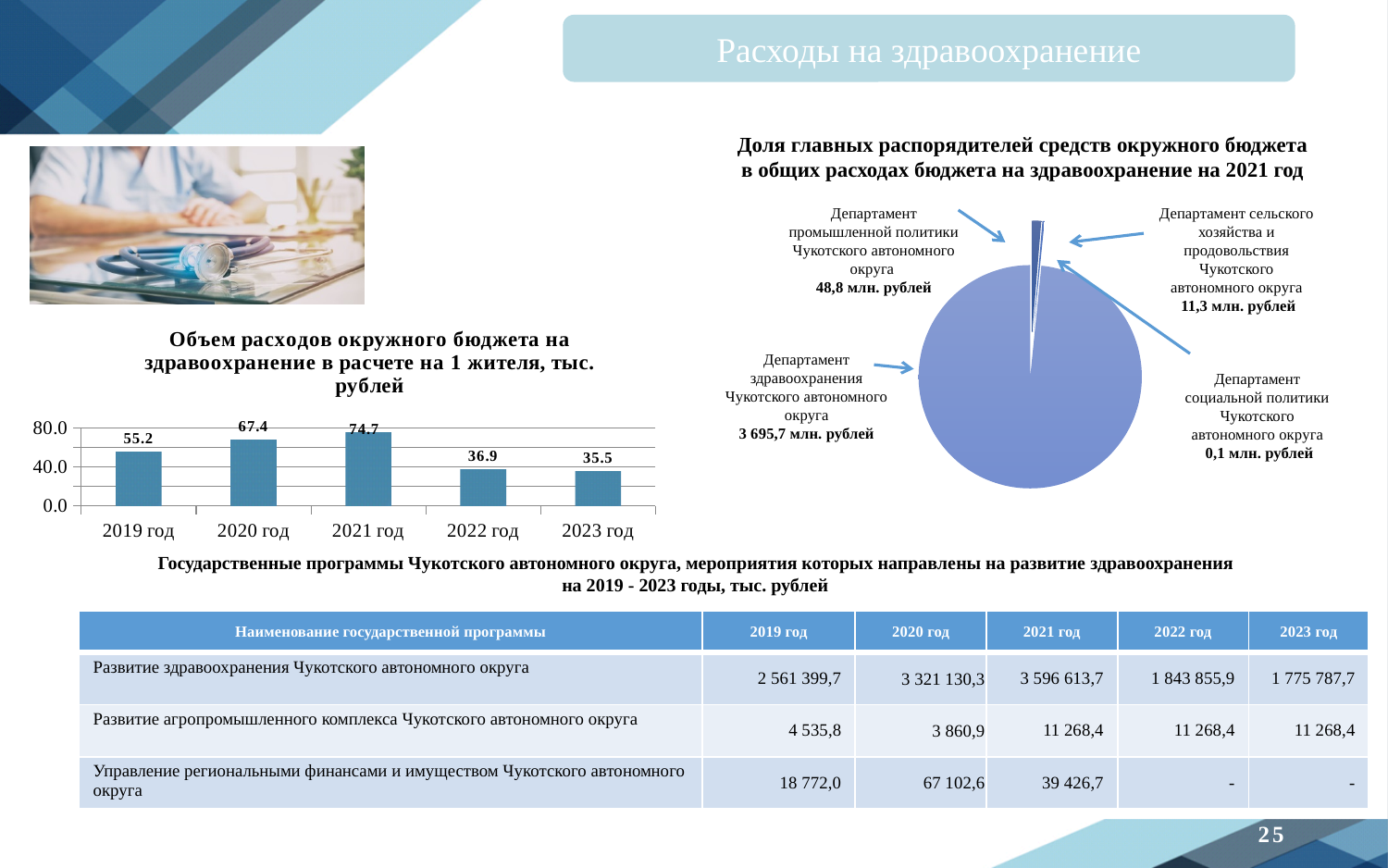
On the pie chart 'Доля главных распорядителей средств окружного бюджета в общих расходах бюджета на здравоохранение на 2021 год', what is the value for Департамент здравоохранения Чукотского автономного округа? 3 695,7 млн. рублей On the bar chart 'Объем расходов окружного бюджета на здравоохранение в расчете на 1 жителя, тыс. рублей', do the values rise or fall from 2021 год to 2023 год? fall On the bar chart 'Объем расходов окружного бюджета на здравоохранение в расчете на 1 жителя, тыс. рублей', which is larger: the value for 2020 год or 2022 год? 2020 год On the pie chart 'Доля главных распорядителей средств окружного бюджета в общих расходах бюджета на здравоохранение на 2021 год', which department has the smallest value? Департамент социальной политики Чукотского автономного округа On the bar chart 'Объем расходов окружного бюджета на здравоохранение в расчете на 1 жителя, тыс. рублей', which year has the highest value? 2021 год On the bar chart 'Объем расходов окружного бюджета на здравоохранение в расчете на 1 жителя, тыс. рублей', what is the difference between the values for 2021 год and 2022 год? 37.8 On the bar chart 'Объем расходов окружного бюджета на здравоохранение в расчете на 1 жителя, тыс. рублей', what is the value for 2021 год? 74.7 On the bar chart 'Объем расходов окружного бюджета на здравоохранение в расчете на 1 жителя, тыс. рублей', what is the value for 2019 год? 55.2 On the bar chart 'Объем расходов окружного бюджета на здравоохранение в расчете на 1 жителя, тыс. рублей', which year has the lowest value? 2023 год What kind of chart is the chart on the left titled 'Объем расходов окружного бюджета на здравоохранение в расчете на 1 жителя, тыс. рублей'? bar chart On the pie chart 'Доля главных распорядителей средств окружного бюджета в общих расходах бюджета на здравоохранение на 2021 год', what is the value for Департамент промышленной политики Чукотского автономного округа? 48,8 млн. рублей On the bar chart 'Объем расходов окружного бюджета на здравоохранение в расчете на 1 жителя, тыс. рублей', how many years are shown? 5